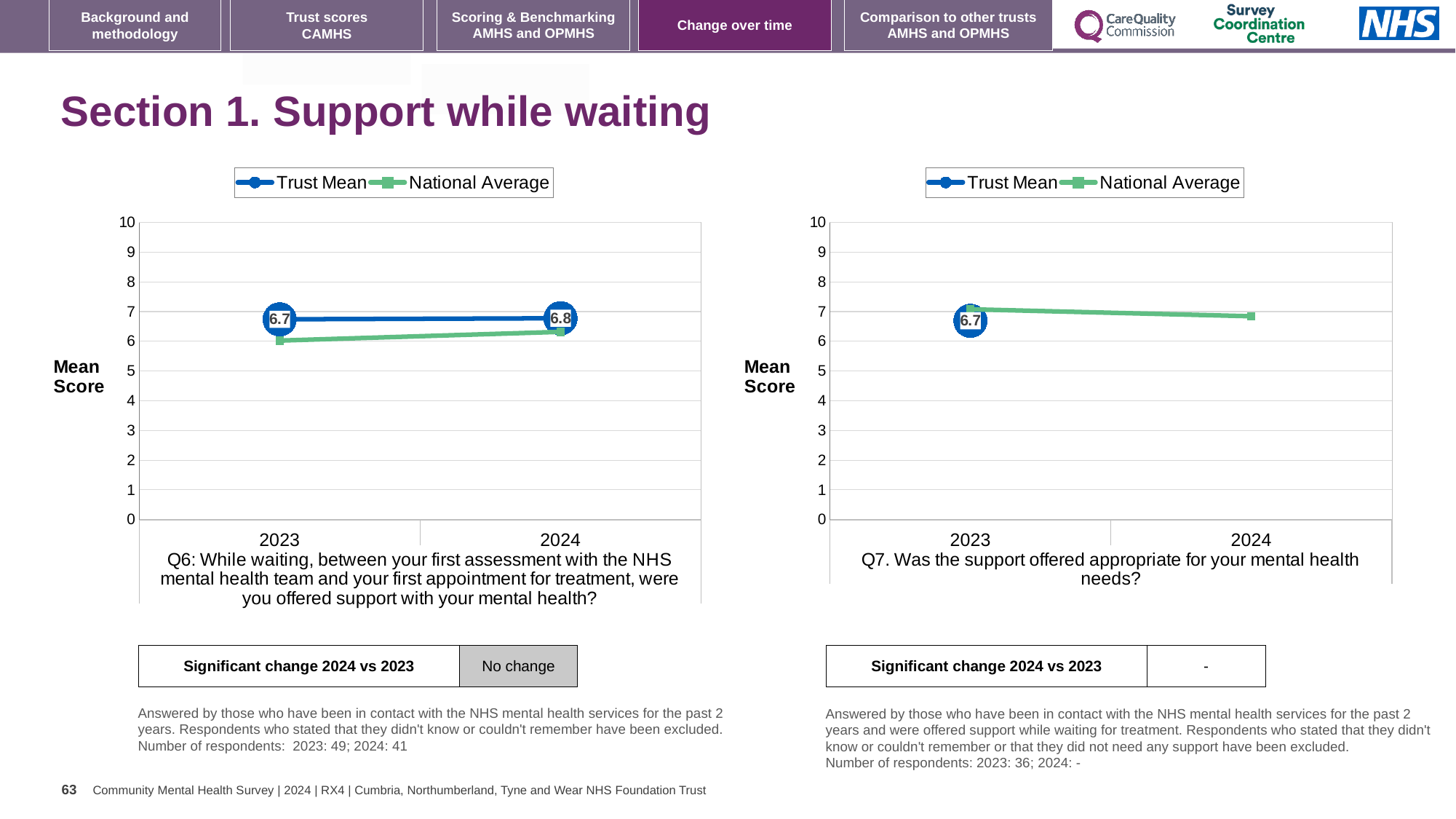
What is the y-axis label on the right chart (Q7)? Mean Score In the left chart (Q6), what is the difference between the Trust Mean values for 2024 and 2023? 0.1 In the left chart (Q6), what is the Trust Mean value for 2023? 6.7 In the left chart (Q6), what is the Trust Mean value for 2024? 6.8 In the left chart (Q6), does the Trust Mean rise or fall from 2023 to 2024? Rise In the right chart (Q7), is the National Average value for 2024 greater or less than 6? greater How many series does the legend of the left chart (Q6) list? 2 In the right chart (Q7), what is the Trust Mean value for 2023? 6.7 In the left chart (Q6), which is larger in 2023: the Trust Mean or the National Average? Trust Mean In the left chart (Q6), is the National Average value for 2023 greater or less than 7? less What kind of chart is the left chart (Q6)? Line chart How many years are shown on the x axis of the right chart (Q7)? 2